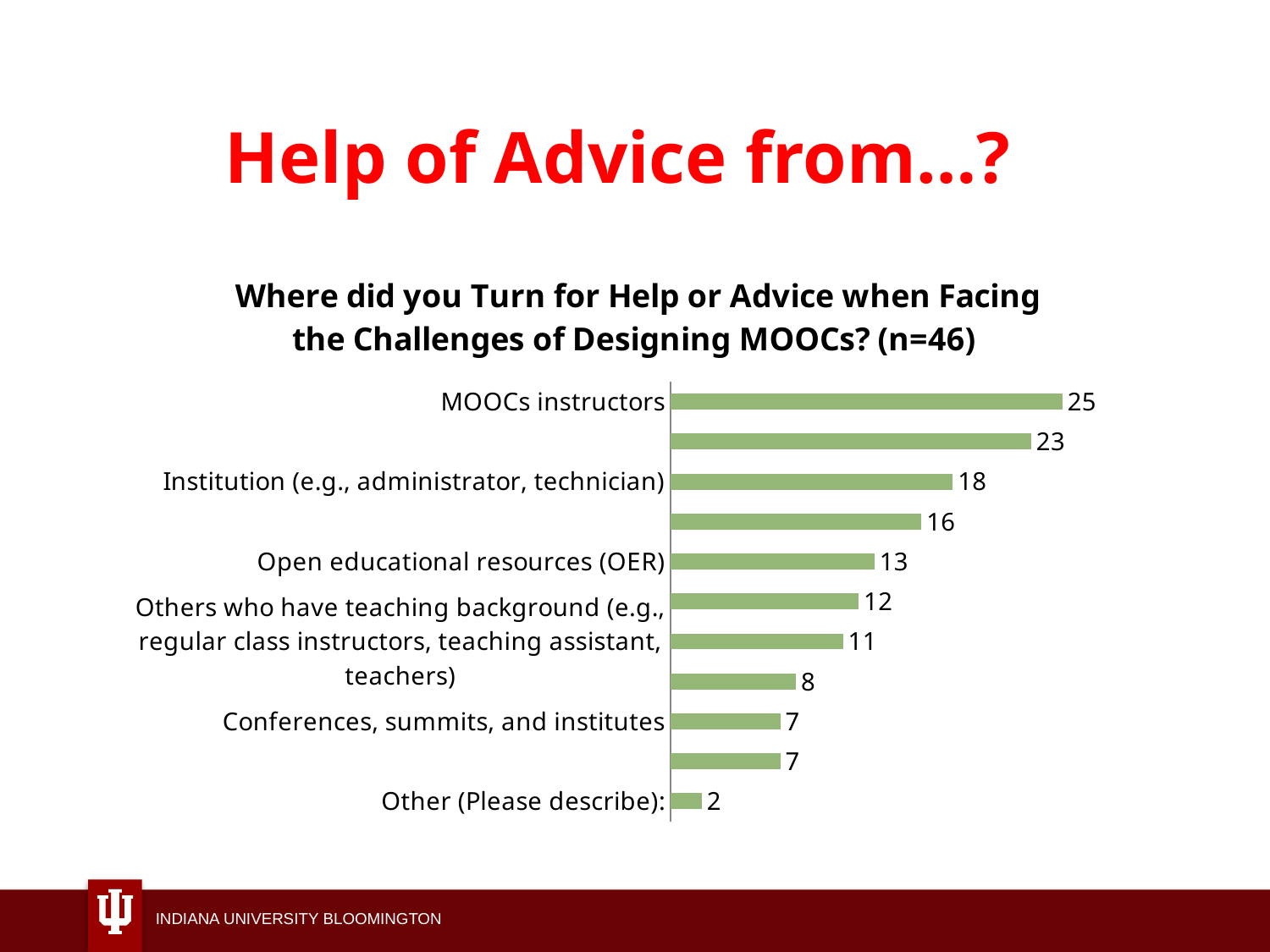
What is the value for Conferences, summits, and institutes? 7 What is the value for Others who have teaching background (e.g., regular class instructors, teaching assistant, teachers)? 11 What is the value for MOOCs instructors? 25 How many bars are plotted in the chart? 11 Which is larger, the value for Open educational resources (OER) or the value for Conferences, summits, and institutes? Open educational resources (OER) What is the value for Open educational resources (OER)? 13 What is the value for Institution (e.g., administrator, technician)? 18 Which category has the highest value? MOOCs instructors What is the difference between the values for MOOCs instructors and Institution (e.g., administrator, technician)? 7 What is the value for Other (Please describe):? 2 What kind of chart is shown on the slide? Bar chart Which category has the lowest value? Other (Please describe):